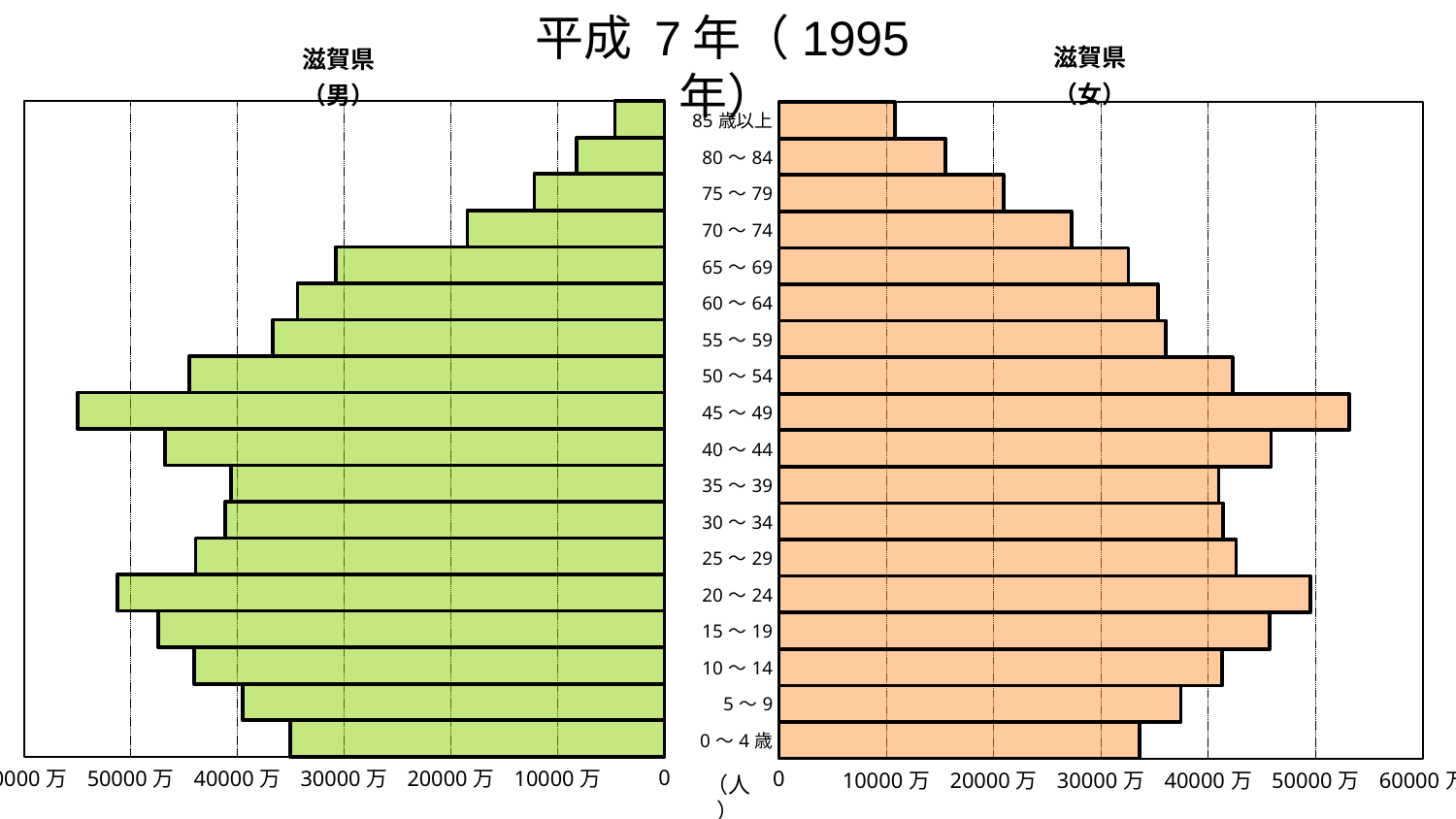
In the 滋賀県（男） chart on the left, is the value for 45～49 greater or less than 50000万? greater What kind of chart is used for the 滋賀県（男） chart on the left? bar chart In the 滋賀県（女） chart on the right, which is larger, the value for 40～44 or the value for 35～39? 40～44 In the 滋賀県（男） chart on the left, which age group has the longest bar? 45～49 In the 滋賀県（女） chart on the right, is the value for 0～4歳 greater or less than 30000万? greater In the 滋賀県（男） chart on the left, which age group has the shortest bar? 85歳以上 What is the title shown at the top of the slide? 平成７年（1995年） In the 滋賀県（女） chart on the right, which age group has the longest bar? 45～49 In the 滋賀県（男） chart on the left, is the value for 85歳以上 greater or less than 10000万? less In the 滋賀県（男） chart on the left, do the bars get longer or shorter going from 45～49 up to 85歳以上? shorter How many age groups are plotted in the 滋賀県（女） chart on the right? 18